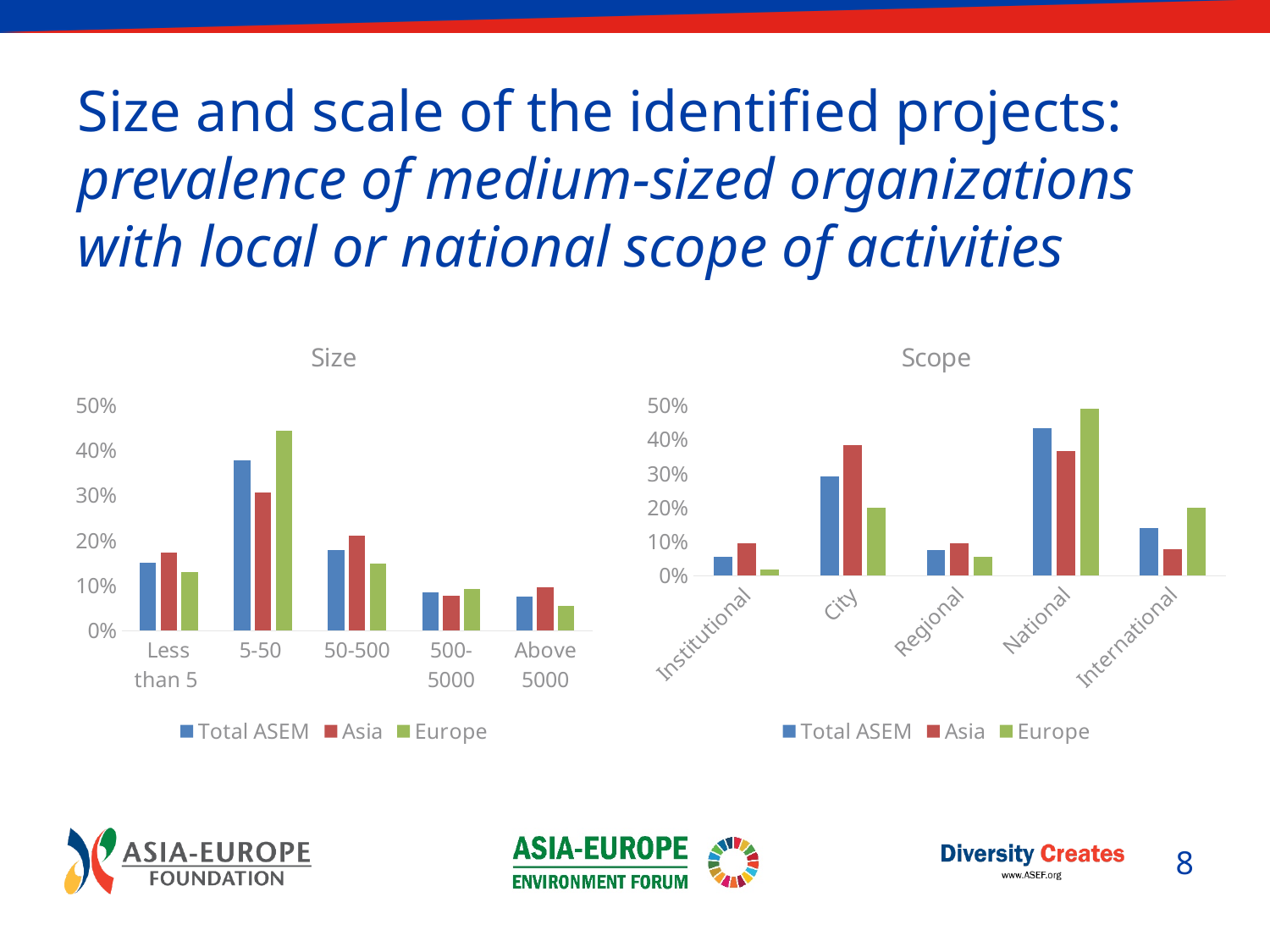
In the "Scope" chart, which category has the highest value for Total ASEM? National How many categories are shown on the x axis of the "Size" chart? 5 In the "Size" chart, which category has the highest value for Europe? 5-50 How many series does the legend of the "Scope" chart list? 3 In the "Size" chart, is the value for Europe in the 5-50 category greater or less than 40%? greater What kind of chart is the "Size" chart? bar chart In the "Scope" chart, which category has the lowest value for Europe? Institutional What are the three series listed in the legend of the "Size" chart? Total ASEM, Asia, Europe In the "Scope" chart, is the value for Asia in the City category greater or less than 30%? greater In the "Scope" chart, is the value for Europe in the National category greater or less than 40%? greater In the "Size" chart, which is larger for the 5-50 category: Asia or Europe? Europe In the "Scope" chart, which is larger for the International category: Asia or Europe? Europe